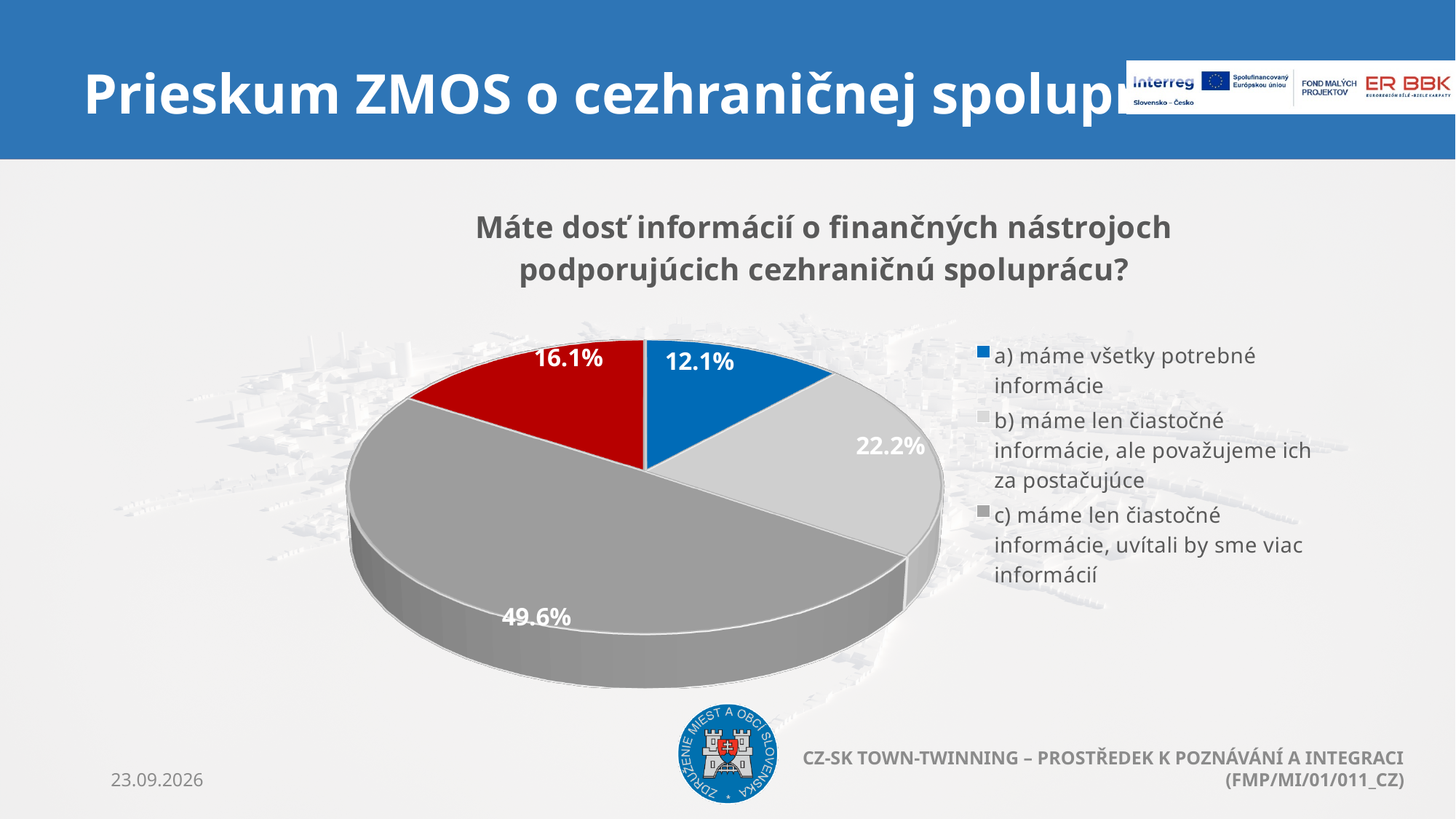
How many slices does the pie chart have? 4 What kind of chart is shown on the slide? Pie chart Which answer option has the smallest share in the pie chart? a) máme všetky potrebné informácie Which has the larger share: option a) or option b)? b) máme len čiastočné informácie, ale považujeme ich za postačujúce What share of respondents answered "a) máme všetky potrebné informácie"? 12.1% What share of respondents answered "b) máme len čiastočné informácie, ale považujeme ich za postačujúce"? 22.2% Which answer option has the largest share in the pie chart? c) máme len čiastočné informácie, uvítali by sme viac informácií What percentage is shown on the red slice of the pie chart? 16.1% How many percentage points larger is the share for option c) than for option b)? 27.4 percentage points What share of respondents answered "c) máme len čiastočné informácie, uvítali by sme viac informácií"? 49.6% How many entries does the legend of the pie chart list? 3 What is the title of the pie chart? Máte dosť informácií o finančných nástrojoch podporujúcich cezhraničnú spoluprácu?